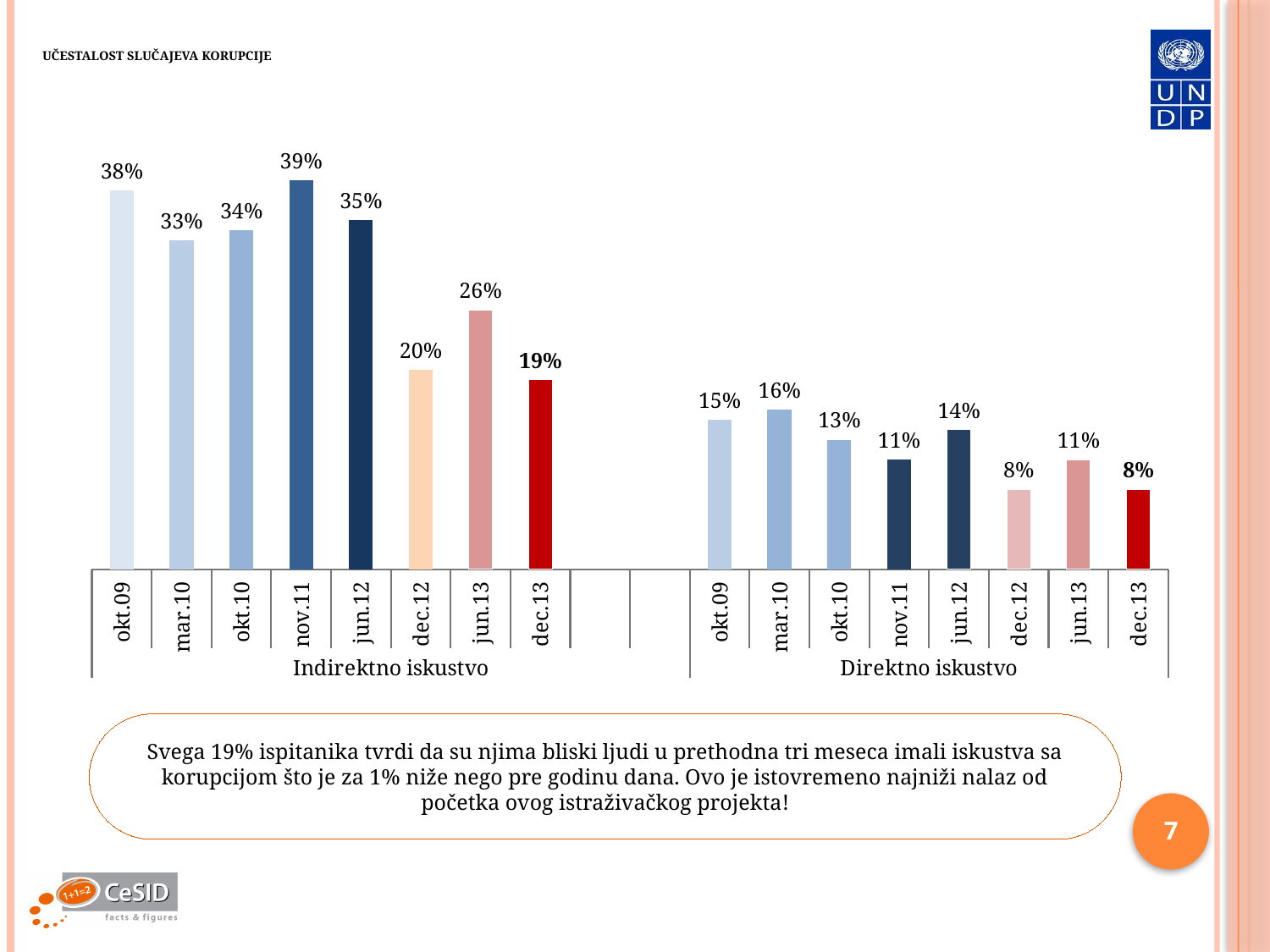
Which period has the lowest value in the Indirektno iskustvo group? dec.13 What is the difference between the okt.09 and dec.13 values in the Indirektno iskustvo group? 19% What kind of chart is shown on the slide? Bar chart Which period has the highest value in the Direktno iskustvo group? mar.10 Which is larger: the jun.12 value for Indirektno iskustvo or the jun.12 value for Direktno iskustvo? Indirektno iskustvo Do the values in the Indirektno iskustvo group rise or fall from jun.12 to dec.13? Fall What value is shown for mar.10 in the Direktno iskustvo group? 16% How many periods are shown in the Direktno iskustvo group? 8 Which period has the highest value in the Indirektno iskustvo group? nov.11 What value is shown for nov.11 in the Indirektno iskustvo group? 39% What value is shown for dec.13 in the Direktno iskustvo group? 8% What is the difference between the jun.13 and dec.13 values in the Direktno iskustvo group? 3%